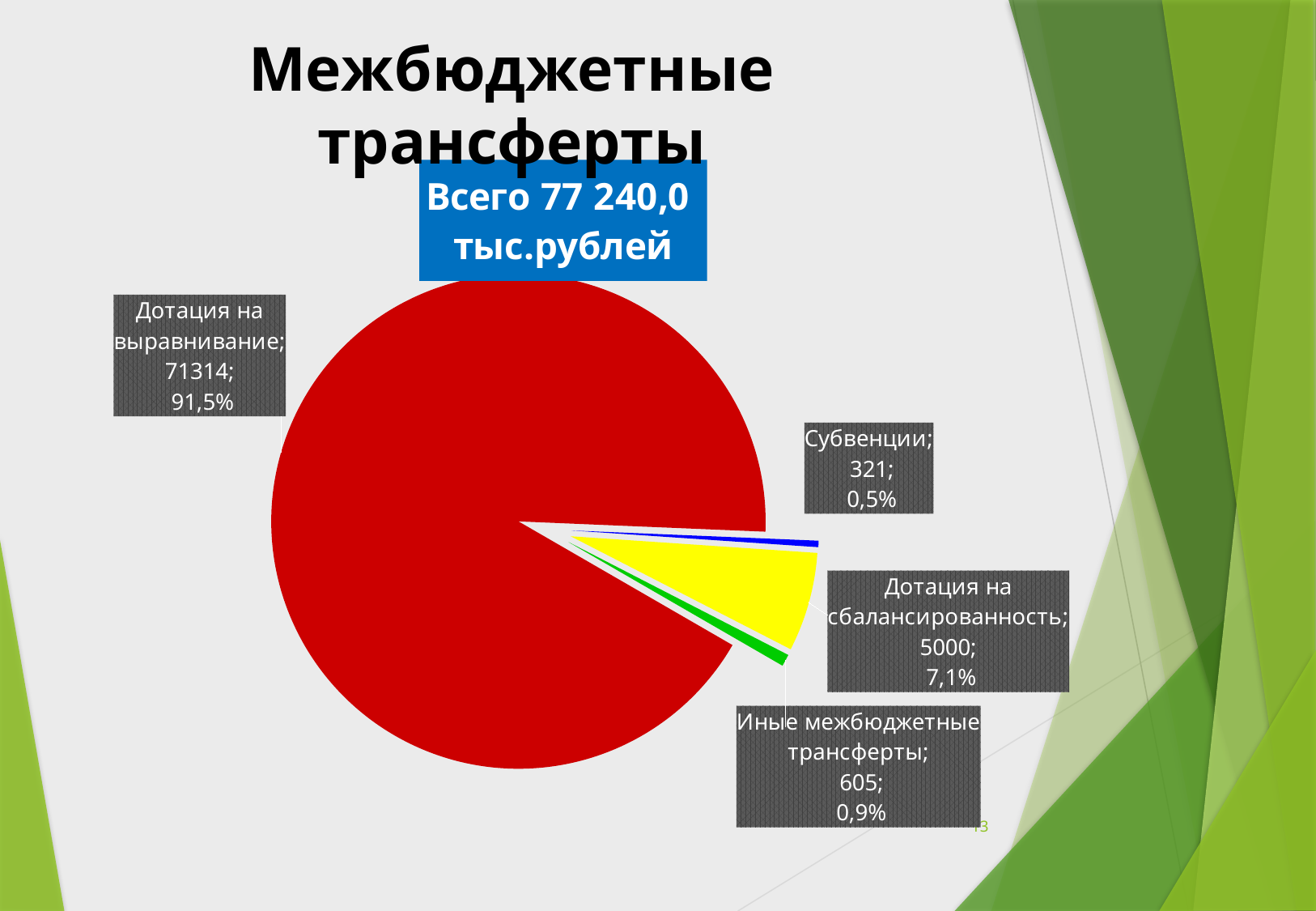
What share of the pie does Иные межбюджетные трансферты represent? 0,9% What is the value for Субвенции? 321 What is the difference between the values for Дотация на сбалансированность and Иные межбюджетные трансферты? 4395 What is the value for Дотация на выравнивание? 71314 How many slices does the pie chart have? 4 What colour is the slice for Дотация на сбалансированность? yellow Which category has the smallest slice of the pie? Субвенции Which is larger, Иные межбюджетные трансферты or Субвенции? Иные межбюджетные трансферты What share of the pie does Дотация на сбалансированность represent? 7,1% What type of chart is shown on the slide? pie chart What total amount is stated in the blue box on the slide? 77 240,0 тыс.рублей Which category has the largest slice of the pie? Дотация на выравнивание